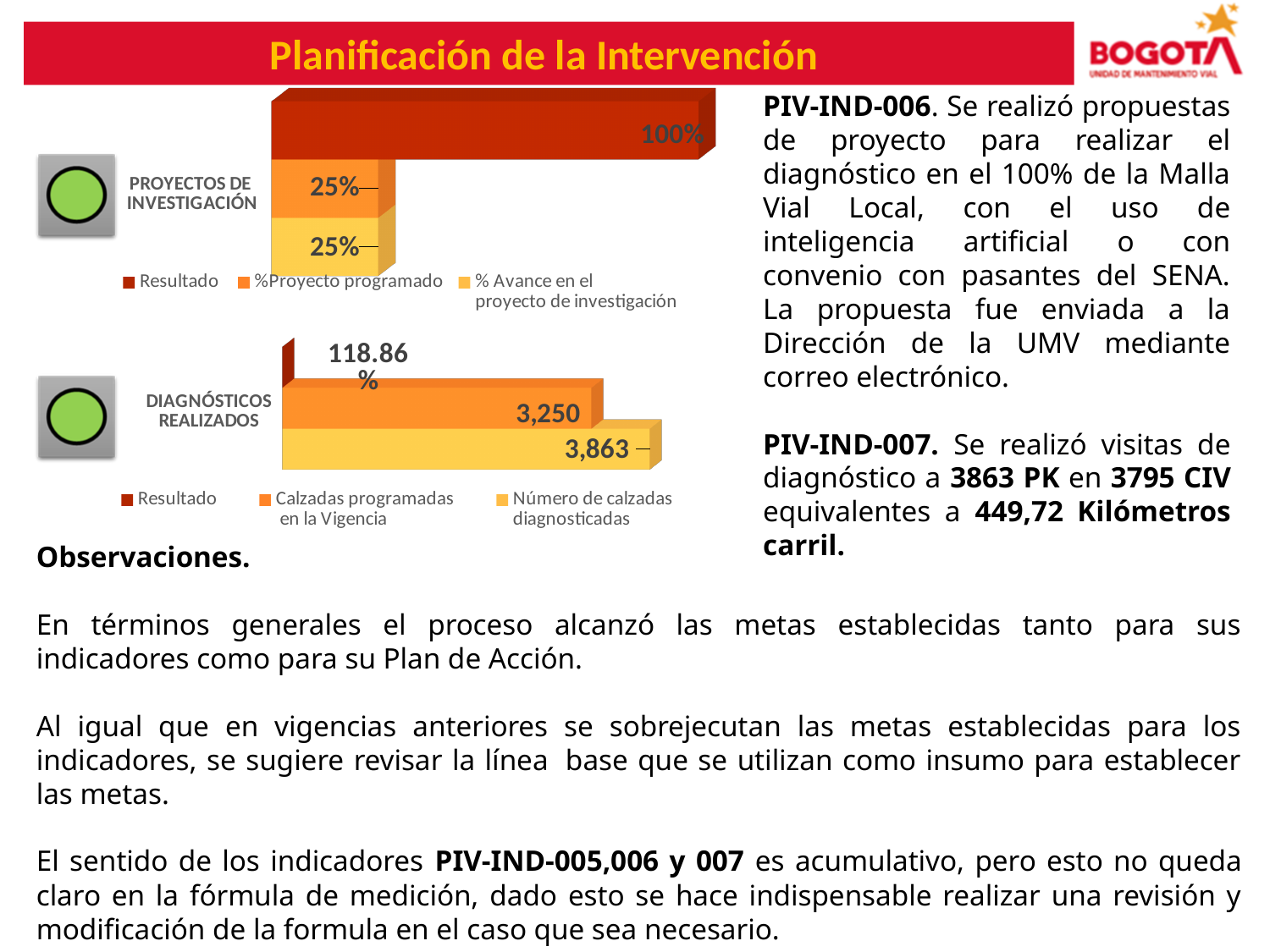
In the DIAGNÓSTICOS REALIZADOS chart, what is the value for Número de calzadas diagnosticadas? 3,863 In the PROYECTOS DE INVESTIGACIÓN chart, how many series does the legend list? 3 In the DIAGNÓSTICOS REALIZADOS chart, what colour is the Número de calzadas diagnosticadas series? Yellow In the PROYECTOS DE INVESTIGACIÓN chart, what is the value of the Resultado bar? 100% In the PROYECTOS DE INVESTIGACIÓN chart, what is the value for % Avance en el proyecto de investigación? 25% In the PROYECTOS DE INVESTIGACIÓN chart, which series has the highest value? Resultado In the PROYECTOS DE INVESTIGACIÓN chart, what is the value for %Proyecto programado? 25% In the DIAGNÓSTICOS REALIZADOS chart, what is the value of the Resultado bar? 118.86% In the DIAGNÓSTICOS REALIZADOS chart, what is the value for Calzadas programadas en la Vigencia? 3,250 What kind of chart is the DIAGNÓSTICOS REALIZADOS chart? Bar chart In the DIAGNÓSTICOS REALIZADOS chart, which is larger: Calzadas programadas en la Vigencia or Número de calzadas diagnosticadas? Número de calzadas diagnosticadas In the DIAGNÓSTICOS REALIZADOS chart, what is the difference between Número de calzadas diagnosticadas and Calzadas programadas en la Vigencia? 613